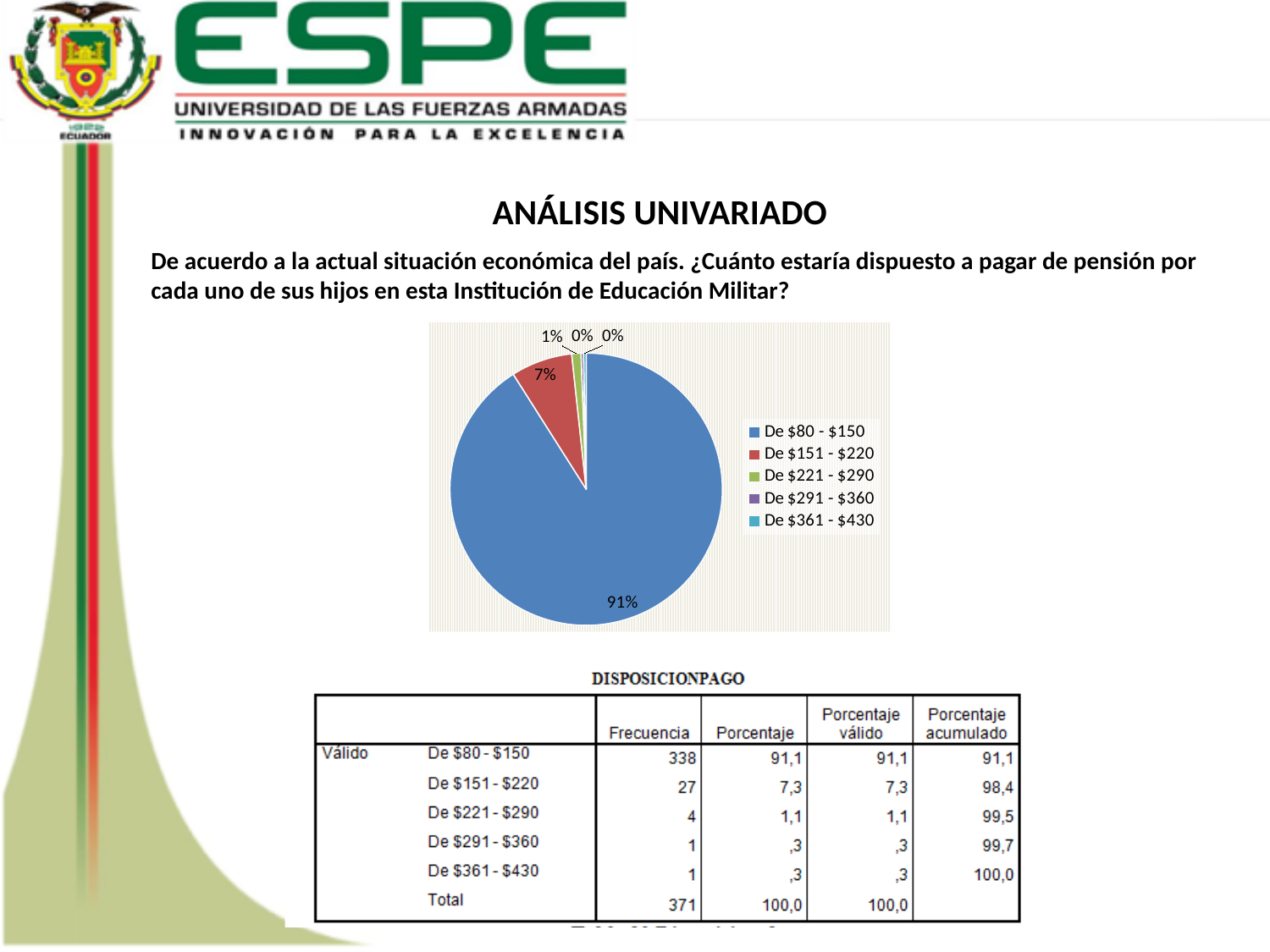
What kind of chart is shown on the slide? pie chart Which category has the largest slice in the pie chart? De $80 - $150 How many categories does the pie chart legend list? 5 Which two categories in the pie chart are labelled 0%? De $291 - $360 and De $361 - $430 What is the difference in percentage points between the De $80 - $150 slice and the De $151 - $220 slice? 84 What percentage of the pie chart corresponds to De $151 - $220? 7% How many slices are labelled in the pie chart? 5 What percentage of the pie chart corresponds to De $221 - $290? 1% What colour is the largest slice of the pie chart? blue What share of the pie does the De $80 - $150 slice represent? 91% What percentage of the pie chart corresponds to De $80 - $150? 91% Which slice is larger in the pie chart: De $151 - $220 or De $221 - $290? De $151 - $220